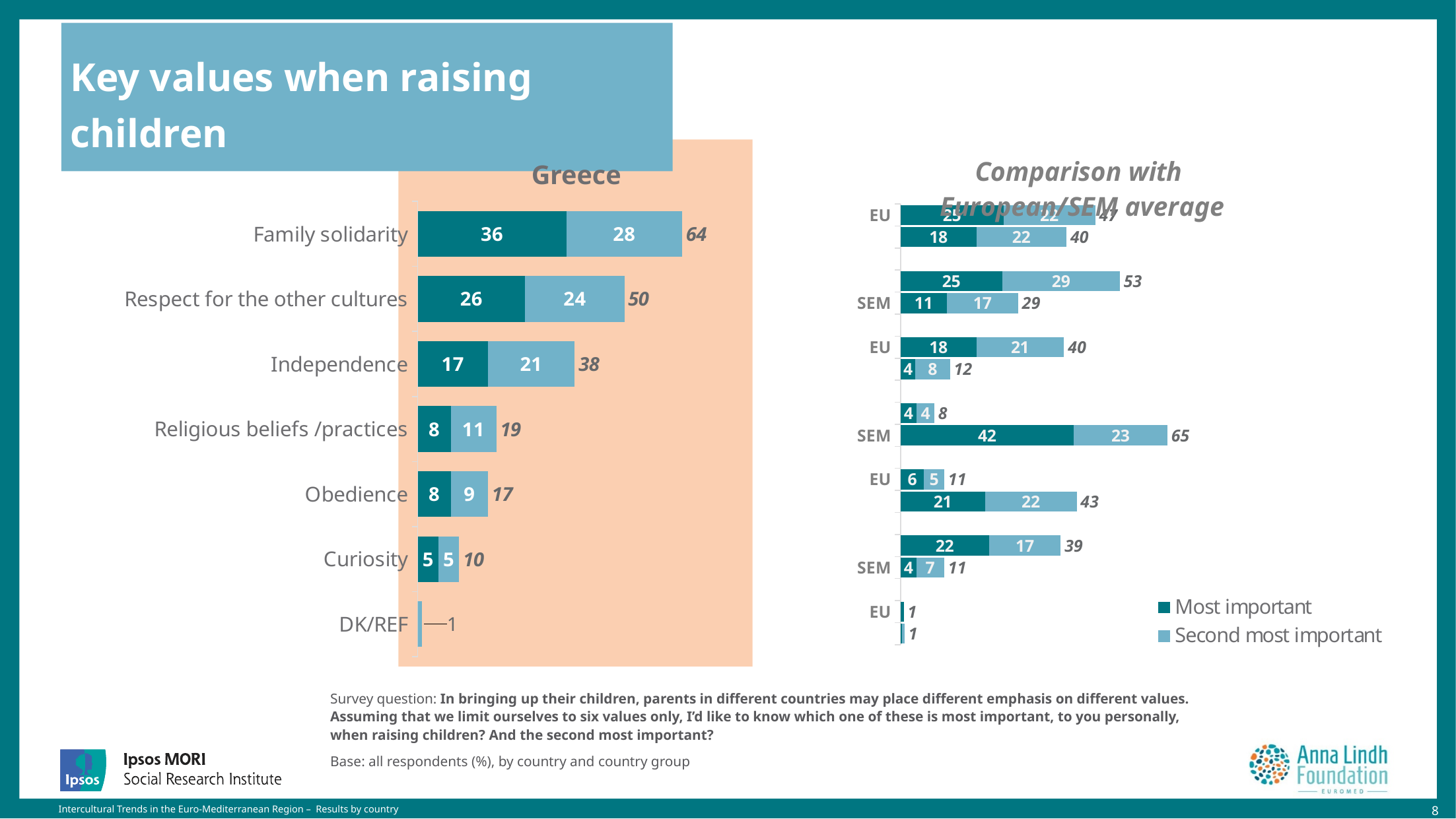
In the Greece chart, what is the difference between the totals for Family solidarity and Respect for the other cultures? 14 In the Greece chart, which has a larger 'Second most important' value: Religious beliefs /practices or Obedience? Religious beliefs /practices In the Greece chart, what is the 'Most important' value for Curiosity? 5 What type of chart is the Greece chart? Bar chart How many series does the legend on the slide list? 2 In the Greece chart, what is the 'Most important' value for Family solidarity? 36 In the Greece chart, which category has the highest total? Family solidarity In the Greece chart, what is the 'Second most important' value for Independence? 21 In the Greece chart, what is the total shown for Respect for the other cultures? 50 How many categories are shown in the Greece chart? 7 In the Greece chart, which category has the lowest total? DK/REF What is the title of the chart on the right side of the slide? Comparison with European/SEM average